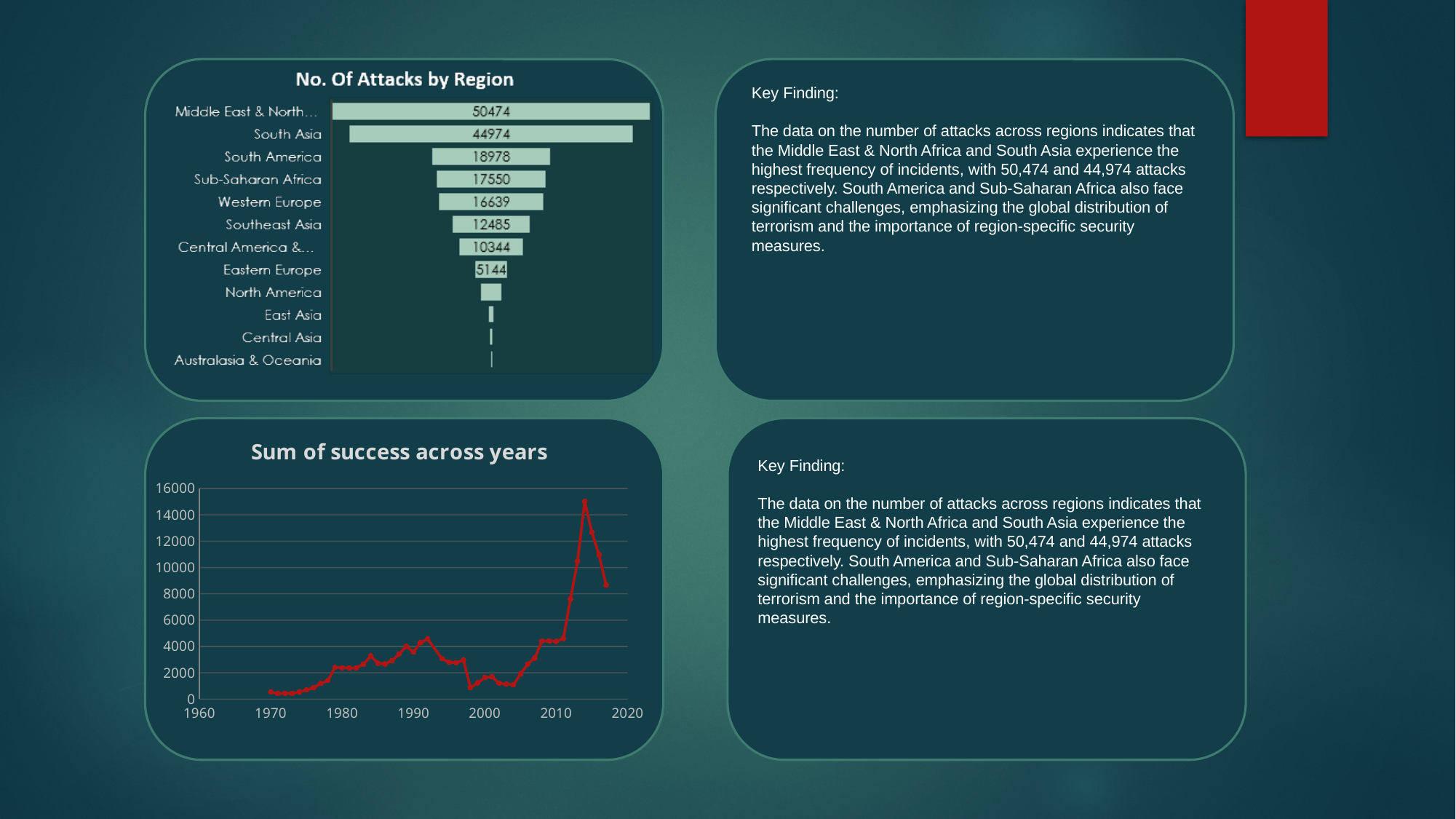
In the 'Sum of success across years' chart, is the peak value around 2014 greater or less than 14000? greater In the 'No. Of Attacks by Region' chart, what is the value for Eastern Europe? 5144 What type of chart is 'No. Of Attacks by Region'? Bar chart In the 'No. Of Attacks by Region' chart, what is the difference between the values for South America and Sub-Saharan Africa? 1428 What type of chart is 'Sum of success across years'? Line chart In the 'No. Of Attacks by Region' chart, how many attacks are shown for South Asia? 44974 In the 'No. Of Attacks by Region' chart, which region has the highest number of attacks? Middle East & North Africa In the 'No. Of Attacks by Region' chart, what is the value for Western Europe? 16639 In the 'No. Of Attacks by Region' chart, which has more attacks, Southeast Asia or Central America &...? Southeast Asia In the 'No. Of Attacks by Region' chart, which region has the lowest number of attacks? Australasia & Oceania In the 'Sum of success across years' chart, is the value around 1970 greater or less than 2000? less How many regions are listed in the 'No. Of Attacks by Region' chart? 12